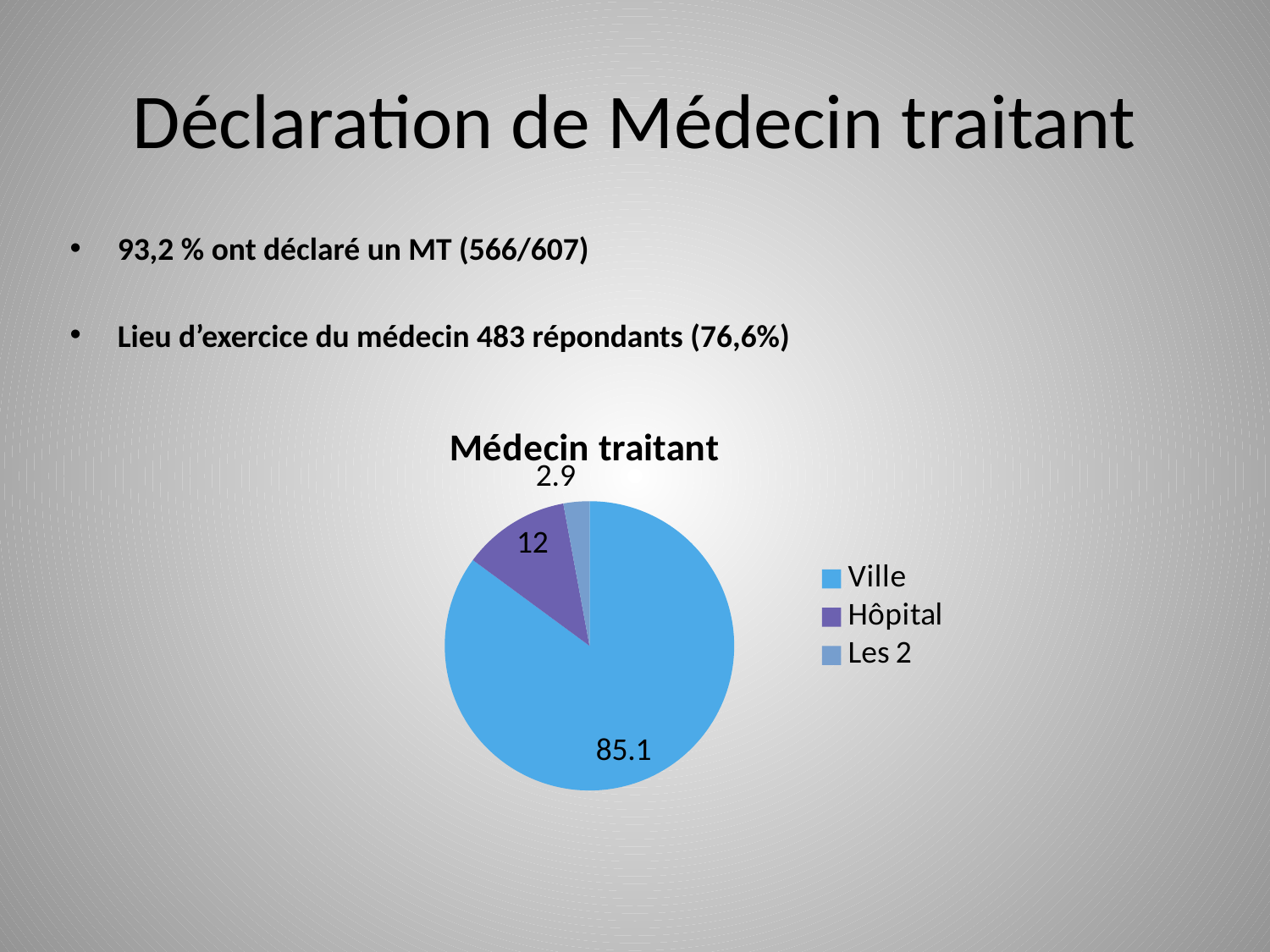
What is the difference between the values for Ville and Hôpital? 73.1 Which is larger, the value for Hôpital or the value for Les 2? Hôpital What is the difference between the values for Hôpital and Les 2? 9.1 Which category has the smallest slice? Les 2 What is the value for Ville? 85.1 What is the value for Les 2? 2.9 Which category has the largest slice? Ville What type of chart is shown on the slide? pie chart What is the title of the chart? Médecin traitant What is the value for Hôpital? 12 How many entries does the legend list? 3 How many slices does the pie chart have? 3